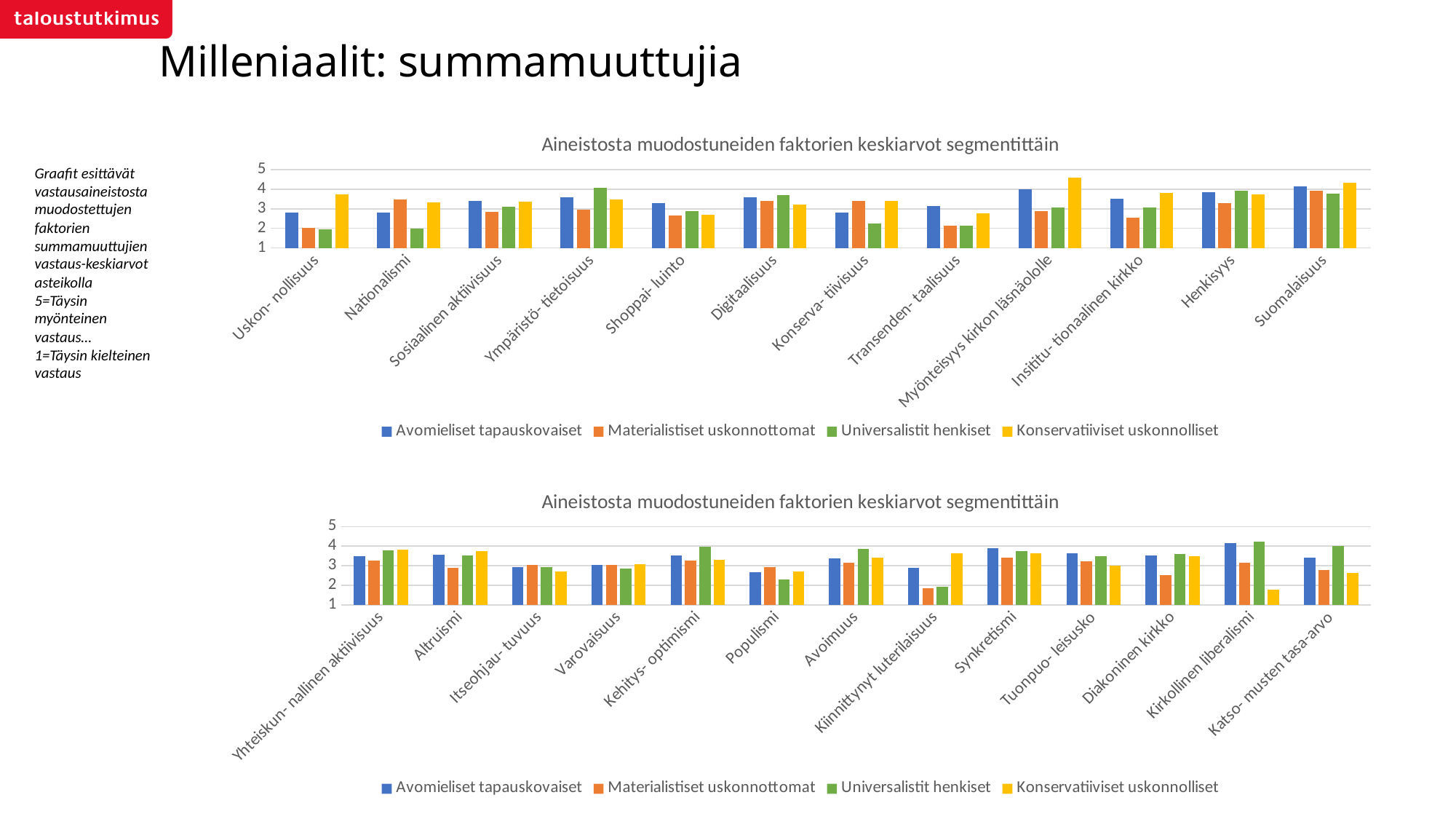
What kind of chart is the top chart on the slide? bar chart In the top chart, for Nationalismi, which is larger: Materialistiset uskonnottomat or Universalistit henkiset? Materialistiset uskonnottomat In the top chart, is the value of Konservatiiviset uskonnolliset for Myönteisyys kirkon läsnäolosta greater or less than 4? greater In the bottom chart, which series has the lowest value for Kirkollinen liberalismi? Konservatiiviset uskonnolliset In the bottom chart, which series has the highest value for Kiinnittynyt luterilaisuus? Konservatiiviset uskonnolliset How many series does the legend of the top chart list? 4 How many categories are shown on the x axis of the bottom chart? 13 In the top chart, which series has the lowest value for Nationalismi? Universalistit henkiset In the top chart, which series has the highest value for Ympäristö-tietoisuus? Universalistit henkiset In the top chart, which series has the highest value for Uskon-nollisuus? Konservatiiviset uskonnolliset What is the title of the bottom chart? Aineistosta muodostuneiden faktorien keskiarvot segmentittäin In the bottom chart, is the value of Konservatiiviset uskonnolliset for Kirkollinen liberalismi greater or less than 2? less